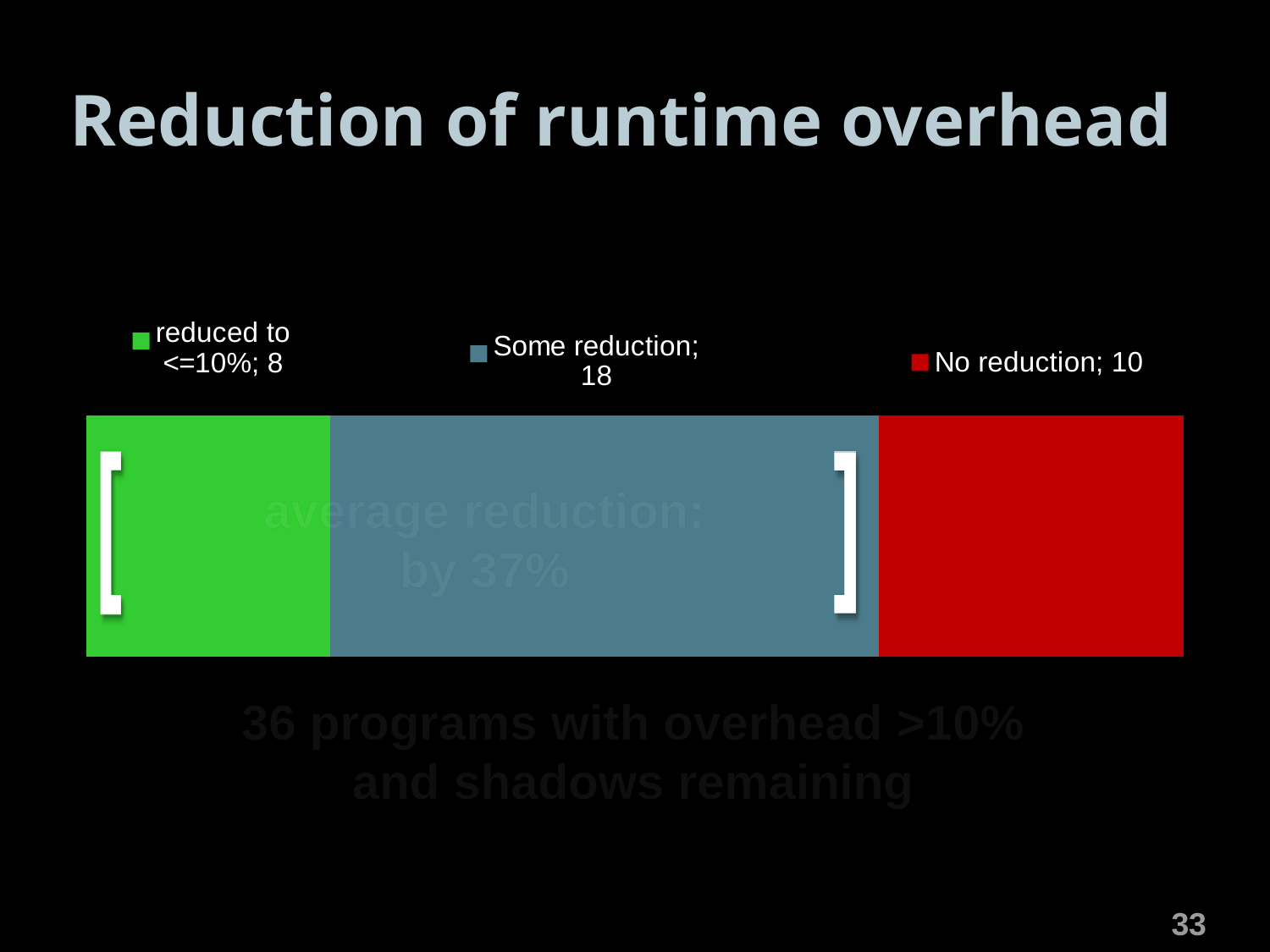
How many series does the legend list? 3 What is the value for "Some reduction"? 18 What kind of chart is shown on the slide? Stacked bar chart Which is larger, the value for "No reduction" or the value for "reduced to <=10%"? No reduction What is the difference between the values for "Some reduction" and "No reduction"? 8 What is the value for "reduced to <=10%"? 8 How many segments does the stacked bar have? 3 What is the value for "No reduction"? 10 Which segment has the highest value? Some reduction What is the difference between the values for "No reduction" and "reduced to <=10%"? 2 Which segment has the lowest value? reduced to <=10% What is the total of all segments in the stacked bar? 36